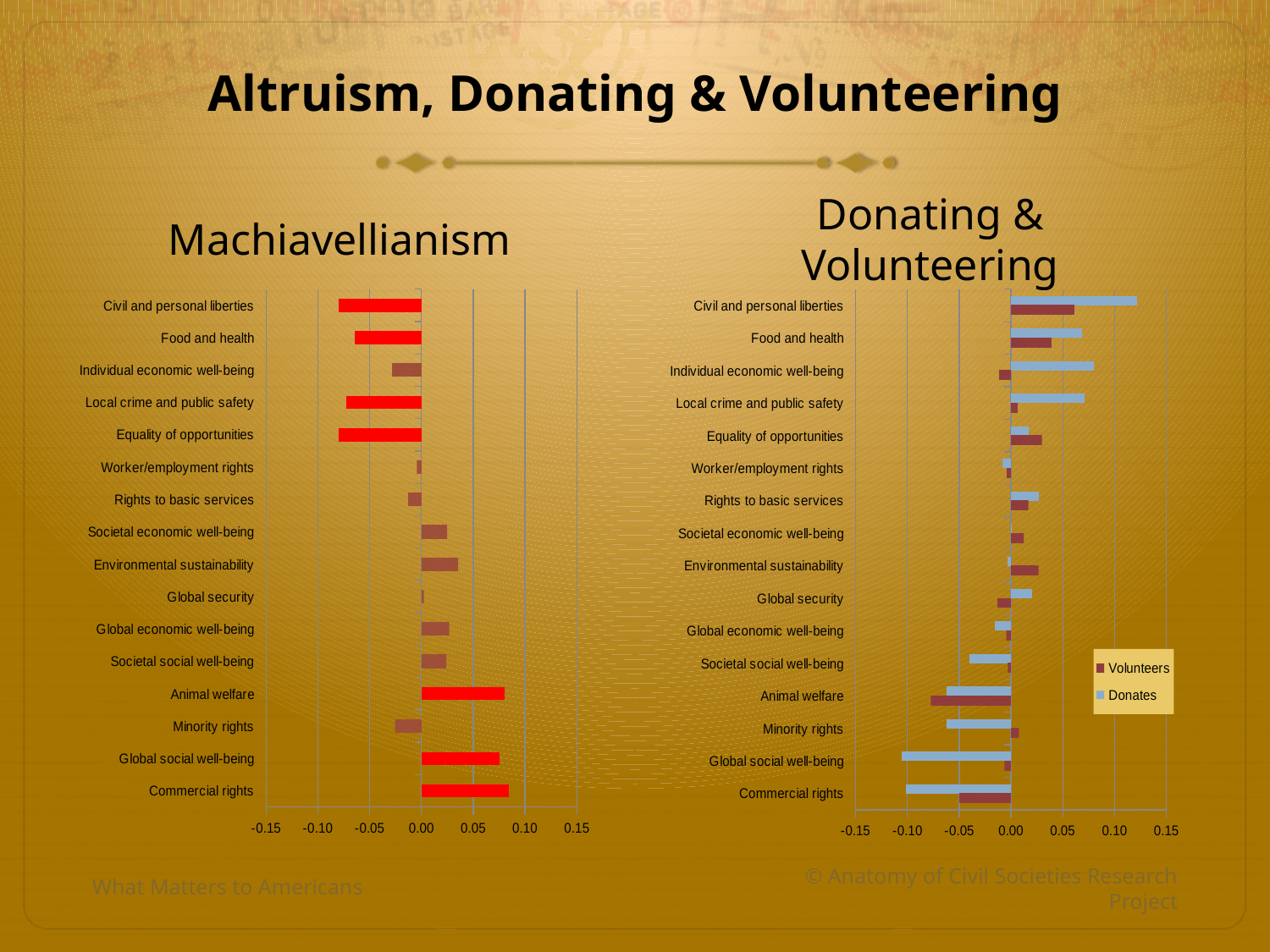
On the Donating & Volunteering chart, for Civil and personal liberties, which is larger: the Donates value or the Volunteers value? Donates On the Donating & Volunteering chart, is the Donates value for Global social well-being greater or less than -0.05? less How many categories are shown on the Machiavellianism chart? 16 On the Donating & Volunteering chart, which category has the lowest Volunteers value? Animal welfare On the Machiavellianism chart, is the value for Animal welfare greater or less than 0.05? greater On the Donating & Volunteering chart, what are the two series named in the legend? Volunteers and Donates On the Machiavellianism chart, which is larger: the value for Environmental sustainability or the value for Societal economic well-being? Environmental sustainability How many series does the legend of the Donating & Volunteering chart list? 2 On the Machiavellianism chart, is the value for Civil and personal liberties greater or less than -0.05? less What kind of chart is the Machiavellianism chart? bar chart On the Donating & Volunteering chart, which category has the highest Donates value? Civil and personal liberties